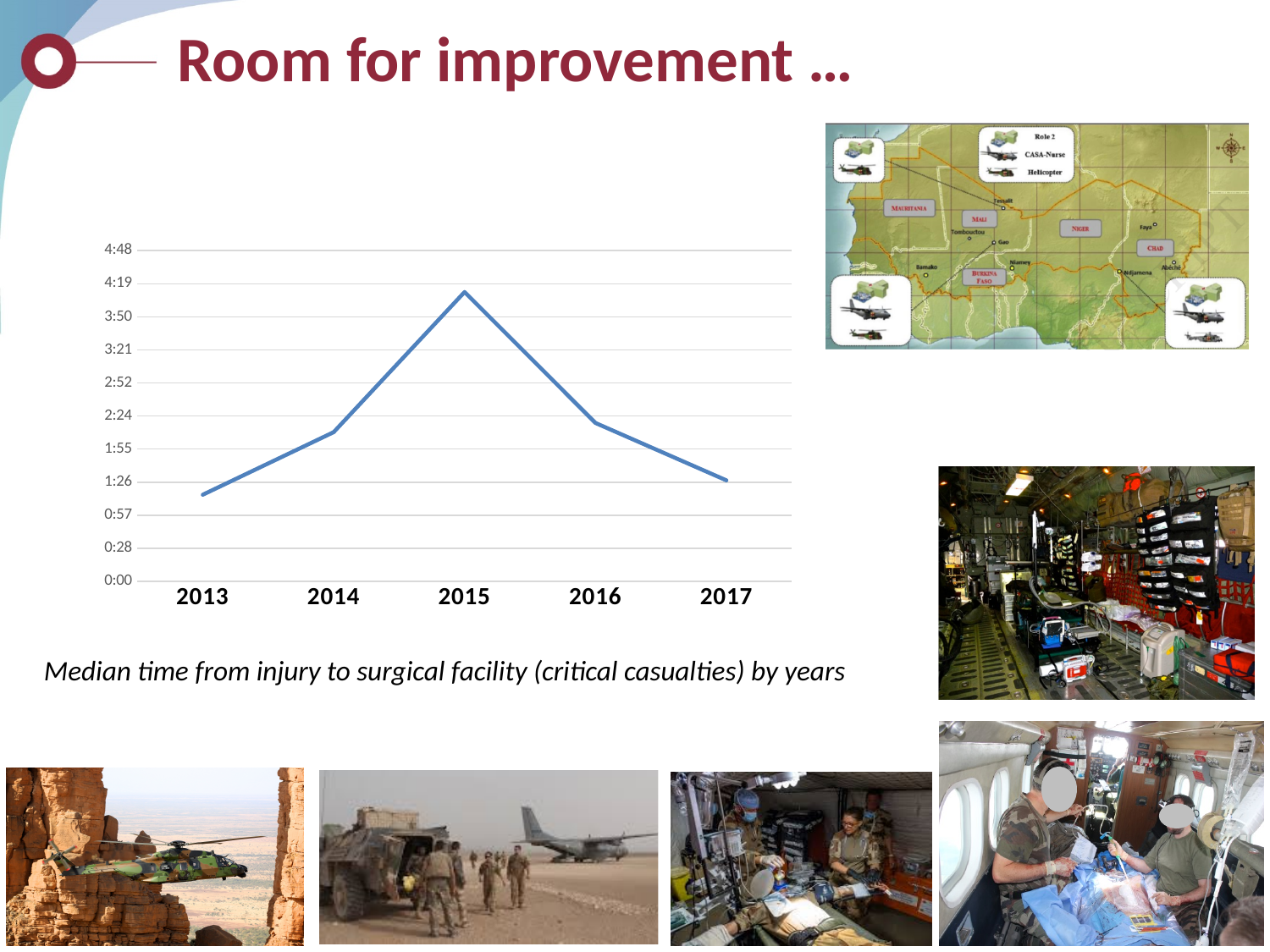
Which is larger, the value for 2015 or the value for 2013? 2015 Is the value for 2015 greater or less than 3:50? greater Is the value for 2016 greater or less than 2:52? less Is the value for 2014 greater or less than 1:55? greater How many years are plotted on the x axis of the chart? 5 How does the median time change from 2013 to 2015? it rises How does the median time change from 2015 to 2017? it falls Which year has the highest median time from injury to surgical facility? 2015 What does the caption below the chart say the chart shows? Median time from injury to surgical facility (critical casualties) by years What kind of chart is shown on the slide? line chart Which year has the lowest median time from injury to surgical facility? 2013